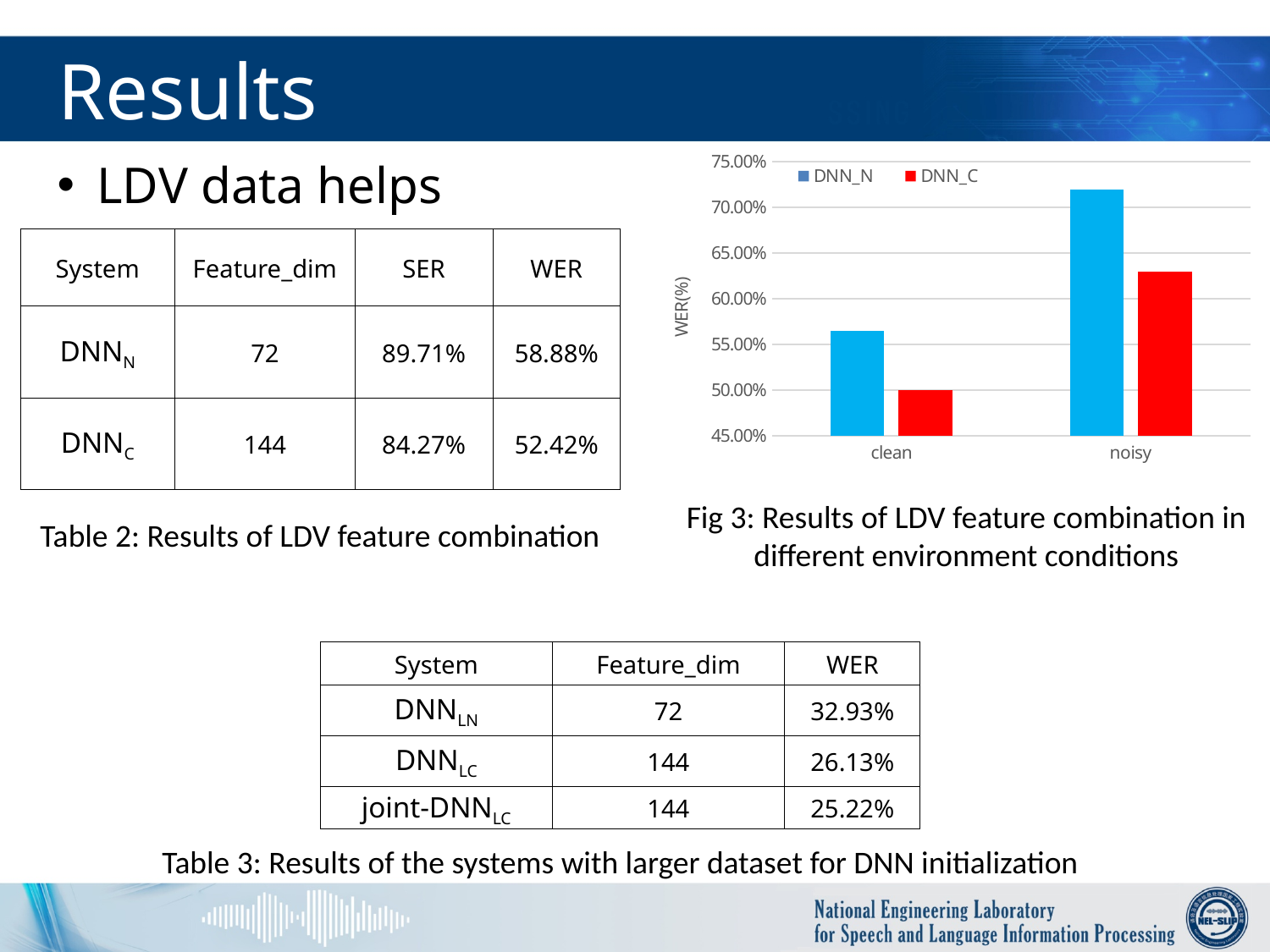
In the Fig 3 chart, which series has the lower WER in the clean condition, DNN_N or DNN_C? DNN_C In the Fig 3 chart, is the WER for DNN_N in the noisy condition greater or less than 70.00%? greater In the Fig 3 chart, which series has the higher WER in the noisy condition, DNN_N or DNN_C? DNN_N In the Fig 3 chart, is the WER for DNN_C in the noisy condition greater or less than 60.00%? greater What kind of chart is shown in Fig 3? bar chart In the Fig 3 chart, which condition has the highest WER for DNN_N? noisy How many categories are shown on the x axis of the Fig 3 chart? 2 In the Fig 3 chart, does the WER for DNN_C rise or fall from clean to noisy? rise In the Fig 3 chart, is the WER for DNN_C in the clean condition greater or less than 55.00%? less In the Fig 3 chart, which condition has the lowest WER for DNN_C? clean How many series does the legend of the Fig 3 chart list? 2 What is the y-axis label of the Fig 3 chart? WER(%)